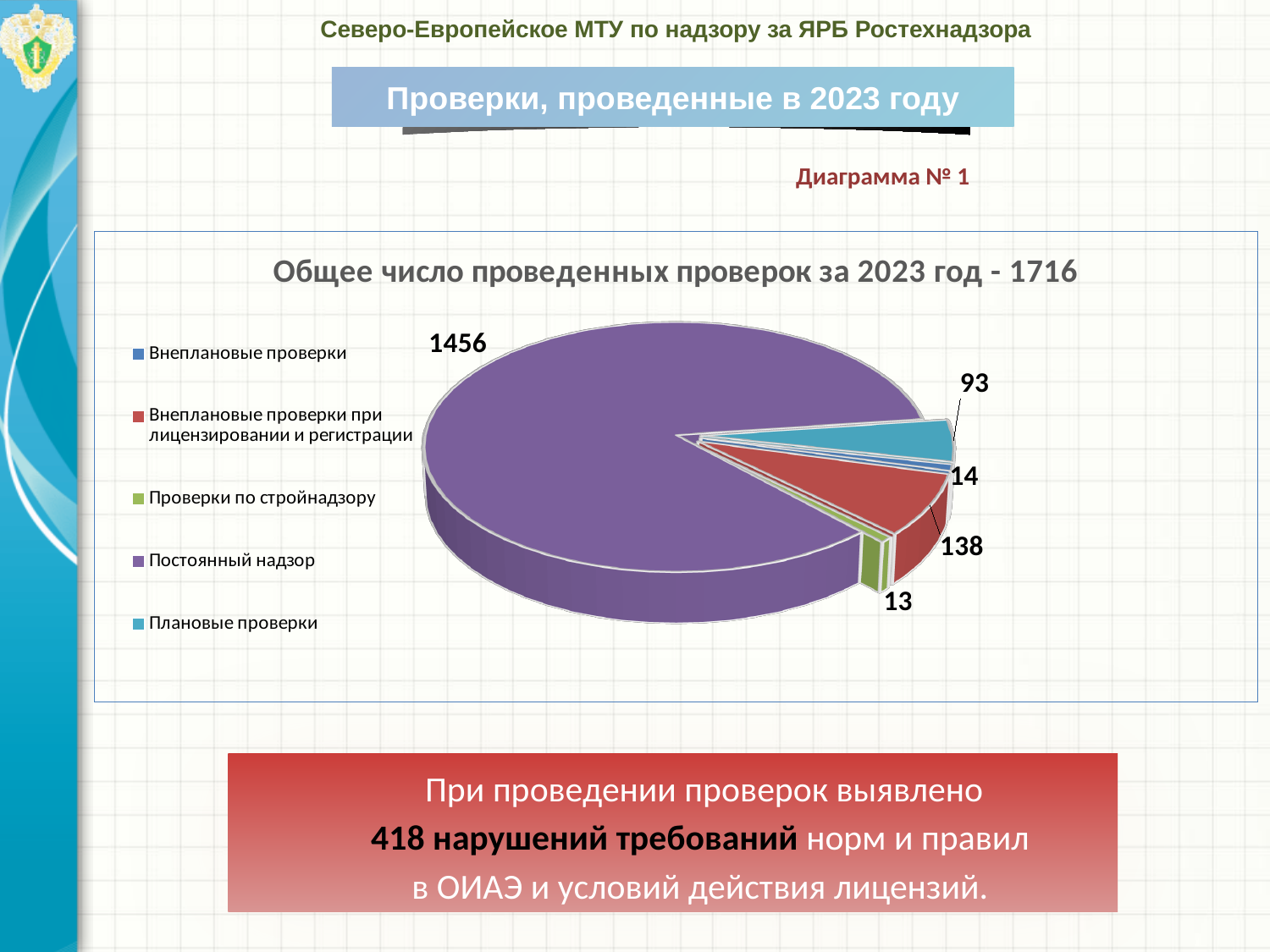
What type of chart is shown on the slide? pie chart Which is larger: Плановые проверки or Внеплановые проверки? Плановые проверки What is the value for Плановые проверки? 93 What is the difference between the values for Внеплановые проверки при лицензировании и регистрации and Плановые проверки? 45 What is the value for Проверки по стройнадзору? 13 What is the value for Внеплановые проверки? 14 What total number of inspections for 2023 is stated in the chart title? 1716 How many categories does the pie chart have? 5 What is the value for Внеплановые проверки при лицензировании и регистрации? 138 What is the value for Постоянный надзор? 1456 Which category has the smallest value? Проверки по стройнадзору Which category has the largest slice of the pie? Постоянный надзор